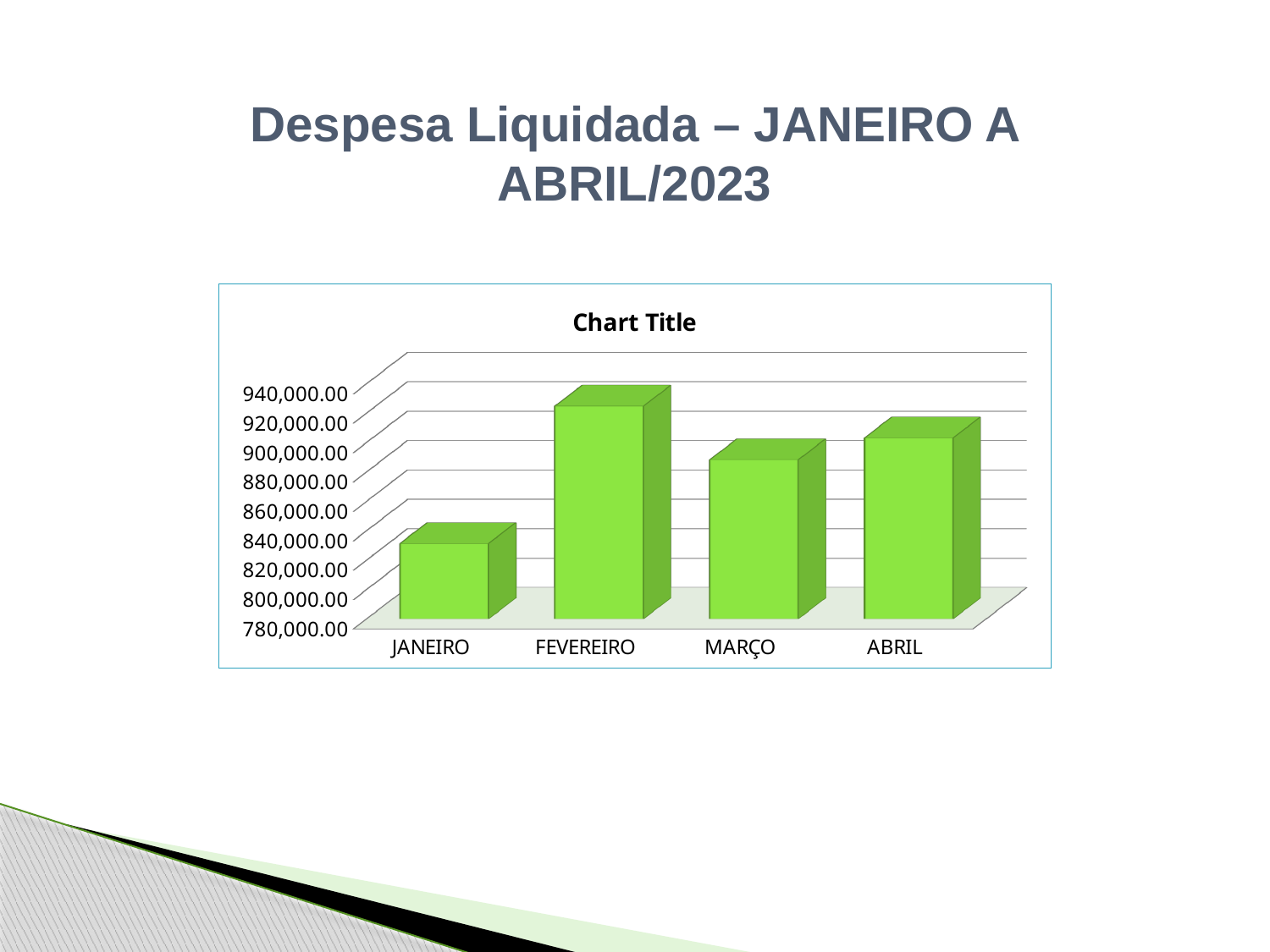
What is the title shown inside the chart area? Chart Title Which is larger, the value for ABRIL or the value for JANEIRO? ABRIL Is the value for MARÇO greater or less than 860,000.00? greater Which month has the highest bar in the chart? FEVEREIRO How many categories are shown on the x axis of the chart? 4 Which is larger, the value for FEVEREIRO or the value for MARÇO? FEVEREIRO Is the value for ABRIL greater or less than 940,000.00? less What kind of chart is shown on the slide? bar chart Which month has the lowest bar in the chart? JANEIRO Is the value for JANEIRO greater or less than 860,000.00? less Does the value rise or fall from JANEIRO to FEVEREIRO? rise